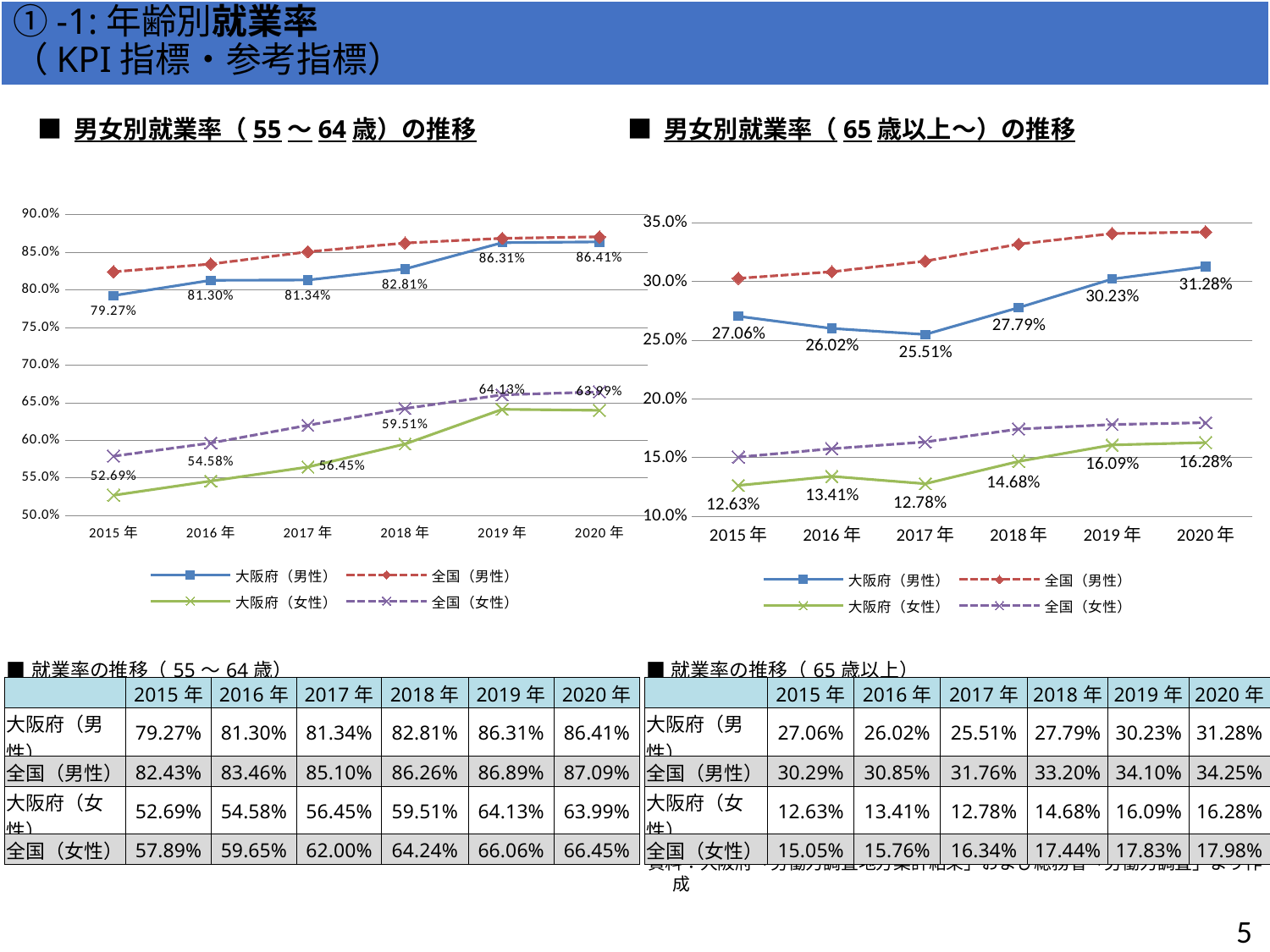
In the left chart (男女別就業率（55～64歳）の推移), what is the difference between the 大阪府（男性） values in 2020年 and 2015年? 7.14 percentage points In the right chart (男女別就業率（65歳以上～）の推移), in which year is the 大阪府（男性） value lowest? 2017年 In the left chart (男女別就業率（55～64歳）の推移), what is the value for 大阪府（男性） in 2015年? 79.27% In the right chart (男女別就業率（65歳以上～）の推移), what is the value for 全国（女性） in 2020年? 17.98% What kind of chart is the left chart (男女別就業率（55～64歳）の推移)? line chart In the left chart (男女別就業率（55～64歳）の推移), in which year is the 大阪府（女性） value highest? 2019年 How many years are plotted along the x axis of the left chart (男女別就業率（55～64歳）の推移)? 6 In the left chart (男女別就業率（55～64歳）の推移), is the value for 全国（女性） in 2015年 greater or less than 60.0%? less In the right chart (男女別就業率（65歳以上～）の推移), what is the value for 大阪府（女性） in 2018年? 14.68% In the right chart (男女別就業率（65歳以上～）の推移), does the 全国（男性） series rise or fall from 2015年 to 2020年? rise How many series does the legend of the right chart (男女別就業率（65歳以上～）の推移) list? 4 In the right chart (男女別就業率（65歳以上～）の推移), which is larger in 2020年: 大阪府（男性） or 全国（男性）? 全国（男性）